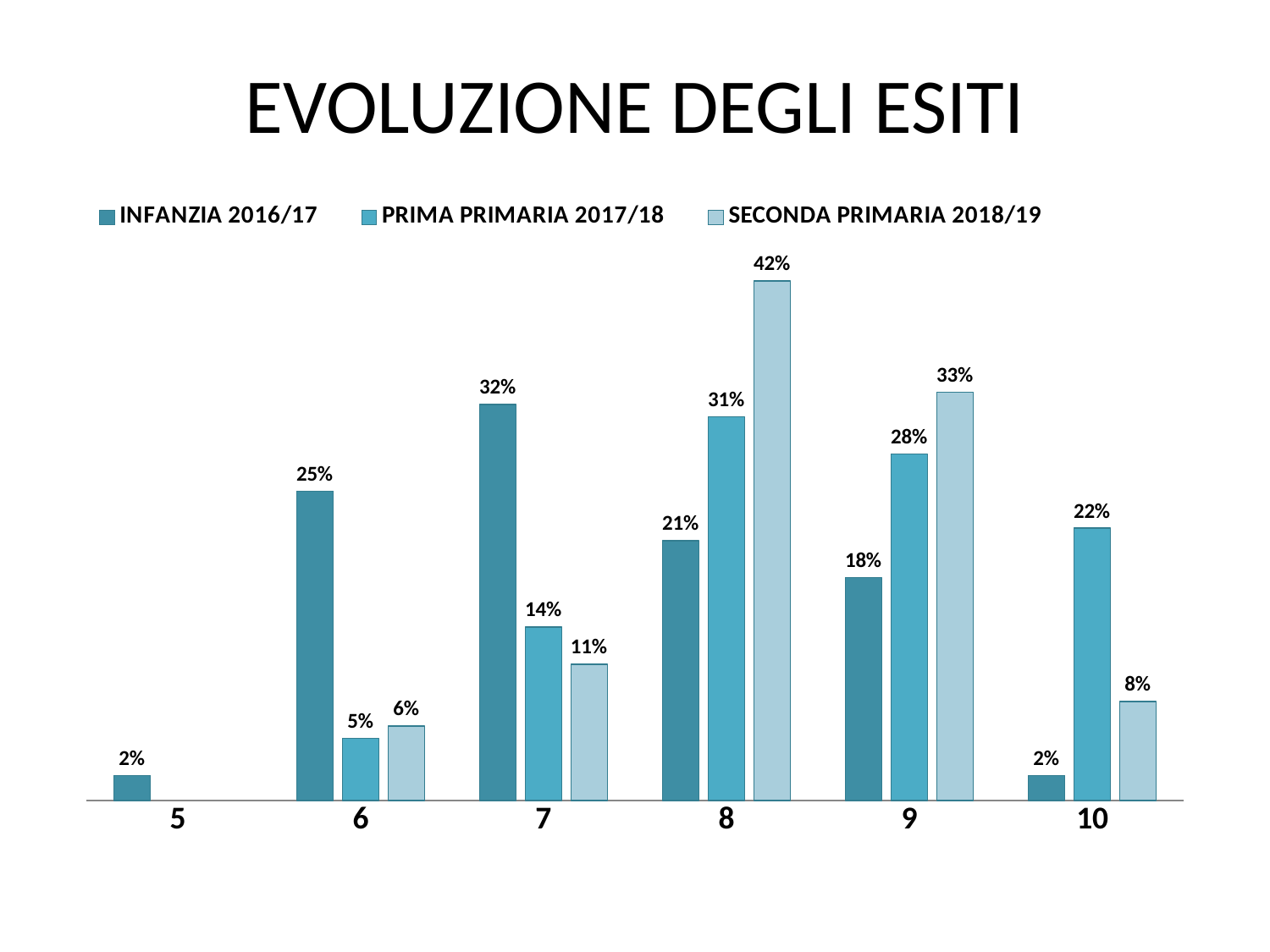
Which category has the lowest value for PRIMA PRIMARIA 2017/18? 6 How many series does the legend list? 3 What is the value for SECONDA PRIMARIA 2018/19 at category 8? 42% What is the difference between the SECONDA PRIMARIA 2018/19 and INFANZIA 2016/17 values at category 8? 21% Which category has the highest value for SECONDA PRIMARIA 2018/19? 8 Which is larger at category 9: PRIMA PRIMARIA 2017/18 or SECONDA PRIMARIA 2018/19? SECONDA PRIMARIA 2018/19 What is the value for PRIMA PRIMARIA 2017/18 at category 10? 22% How many categories are shown on the x axis? 6 What is the value for INFANZIA 2016/17 at category 5? 2% What is the value for INFANZIA 2016/17 at category 7? 32% What kind of chart is shown on the slide? Bar chart What is the title of the chart? EVOLUZIONE DEGLI ESITI